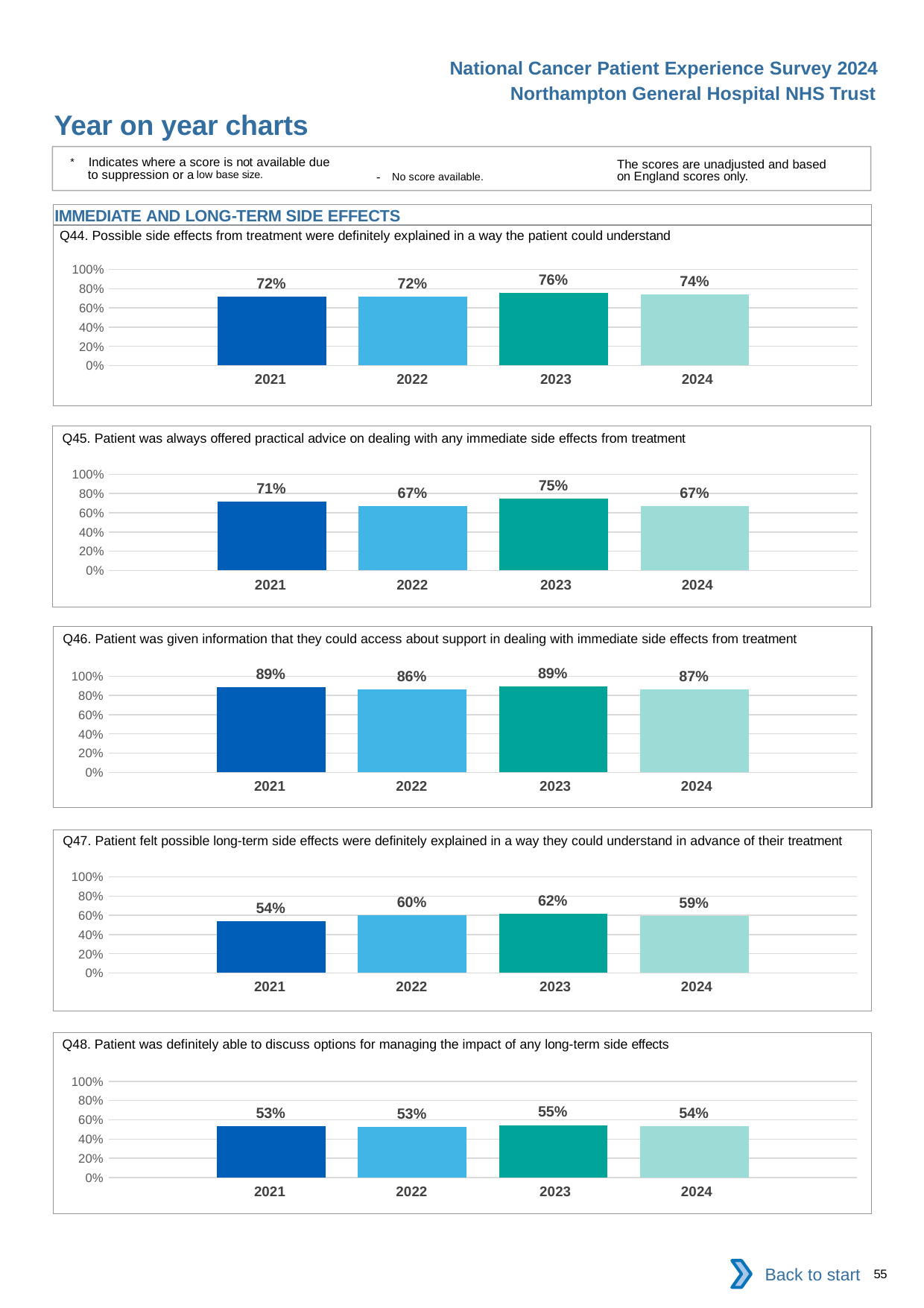
What kind of chart is the Q45 chart? Bar chart In the Q47 chart, is the value for 2021 greater or less than 60%? less In the Q45 chart, which year has the highest value? 2023 In the Q46 chart, what is the value for 2022? 86% In the Q47 chart, which year has the lowest value? 2021 In the Q46 chart, which is larger, the value for 2022 or the value for 2024? 2024 In the Q44 chart, what is the value for 2023? 76% In the Q45 chart, what is the difference between the 2023 value and the 2024 value? 8 percentage points In the Q47 chart, what is the difference between the 2023 value and the 2021 value? 8 percentage points How many years are shown in the Q44 chart? 4 In the Q48 chart, what is the value for 2024? 54% In the Q48 chart, which year has the highest value? 2023